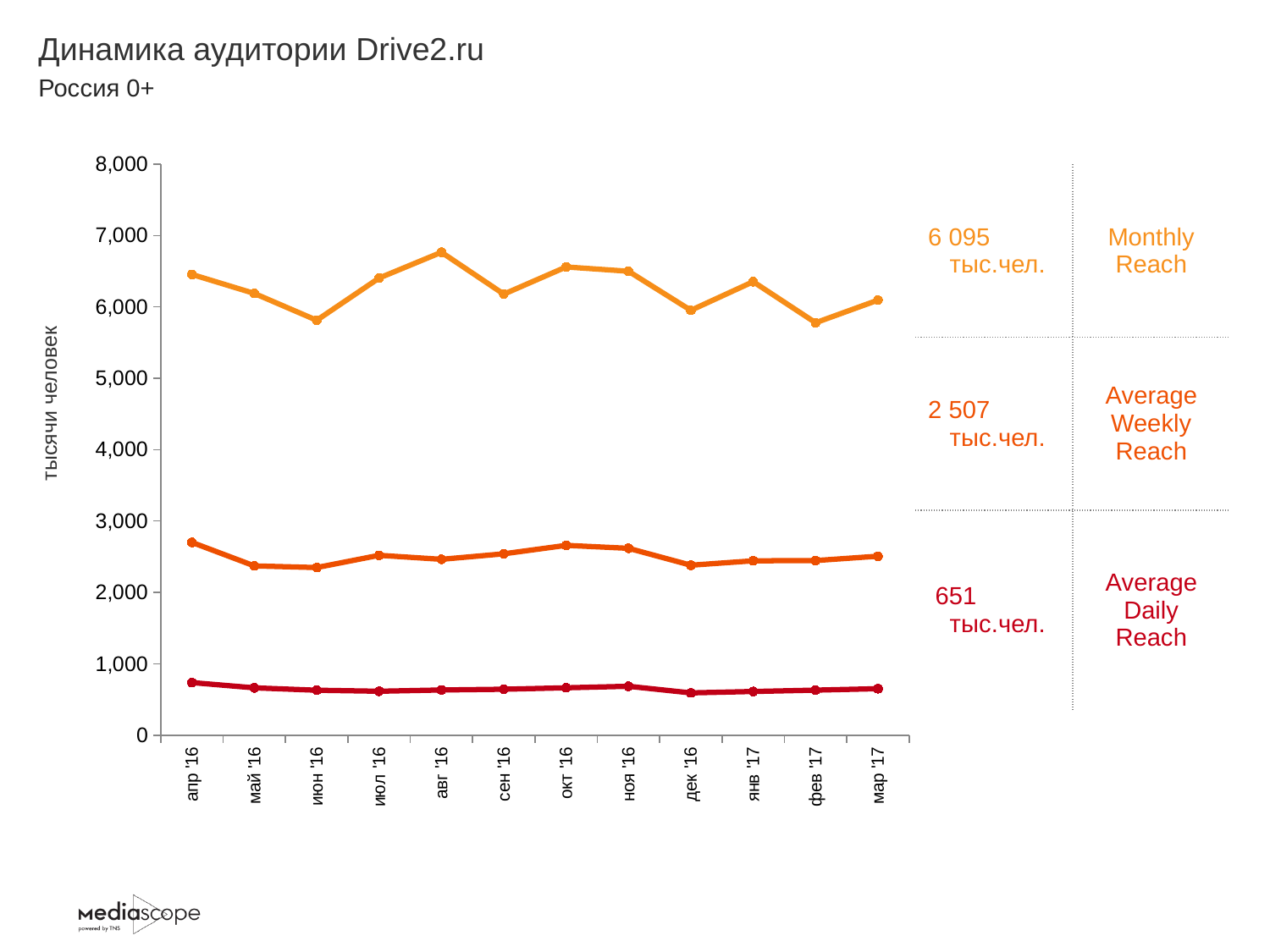
Is the Monthly Reach value for авг '16 greater or less than 6,000? greater Is the Monthly Reach value for июн '16 greater or less than 6,000? less Is the Average Daily Reach value for апр '16 greater or less than 1,000? less What kind of chart is shown on the slide? line chart How many series does the chart show? 3 Between апр '16 and июн '16, does Monthly Reach rise or fall? fall In which month is Monthly Reach highest? авг '16 What Monthly Reach value is printed in the panel to the right of the chart? 6 095 тыс.чел. In which month is Average Daily Reach highest? апр '16 Which is larger in апр '16: Average Weekly Reach or Average Daily Reach? Average Weekly Reach How many months are plotted along the x axis? 12